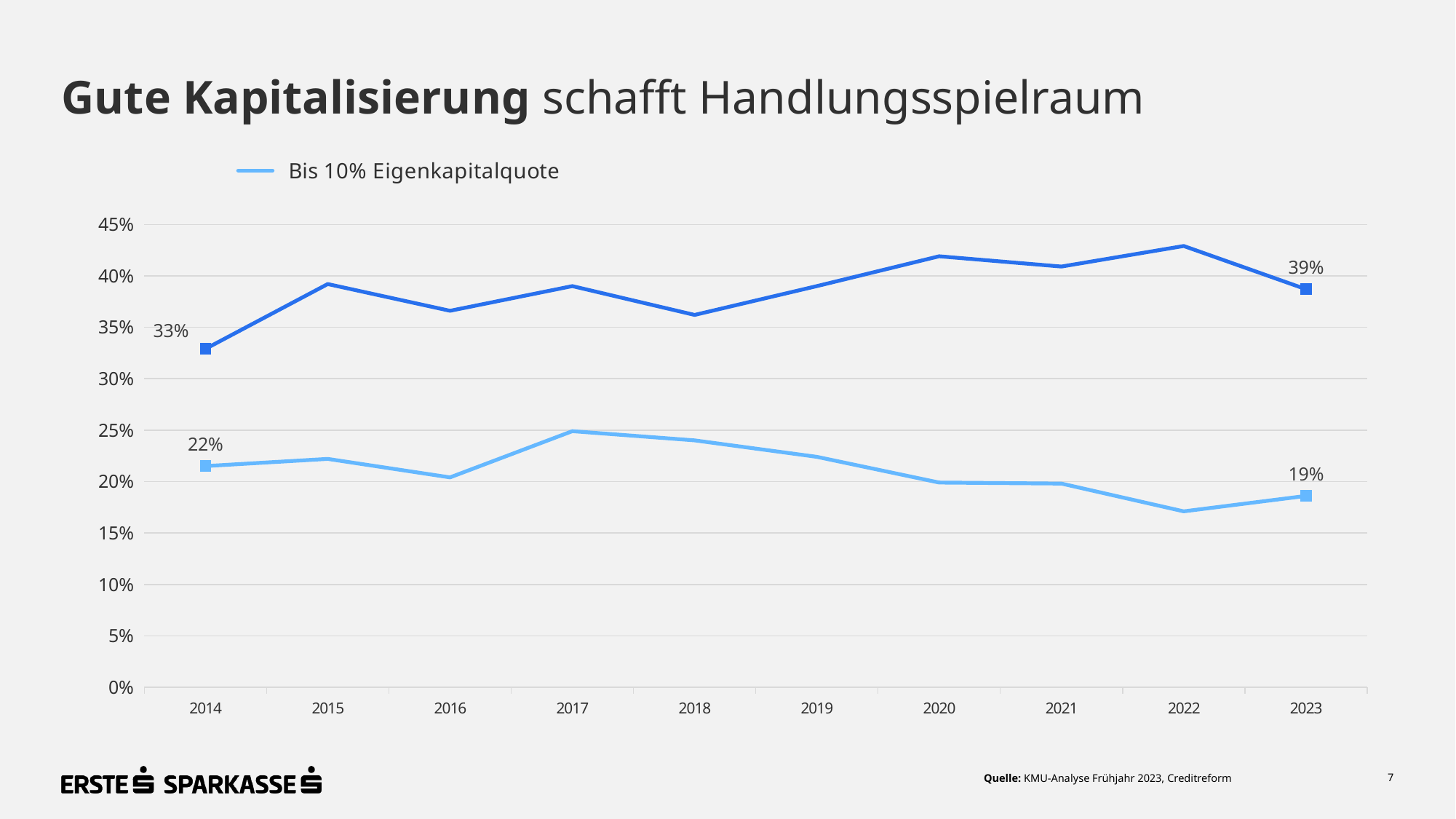
Is the Bis 10% Eigenkapitalquote value for 2022 greater or less than 20%? less What is the value of the Bis 10% Eigenkapitalquote line in 2023? 19% How many series does the legend list? 1 Which is larger for the dark blue line: the 2014 value or the 2023 value? 2023 (39%) What is the value of the Bis 10% Eigenkapitalquote line in 2014? 22% In which year is the Bis 10% Eigenkapitalquote line at its lowest? 2022 Is the Bis 10% Eigenkapitalquote value for 2017 greater or less than 20%? greater What is the data label on the dark blue line in 2023? 39% What kind of chart is shown on the slide? Line chart By how many percentage points did the Bis 10% Eigenkapitalquote value fall from 2014 to 2023? 3 percentage points How many years are shown on the x axis? 10 Does the Bis 10% Eigenkapitalquote line rise or fall between 2020 and 2022? Fall